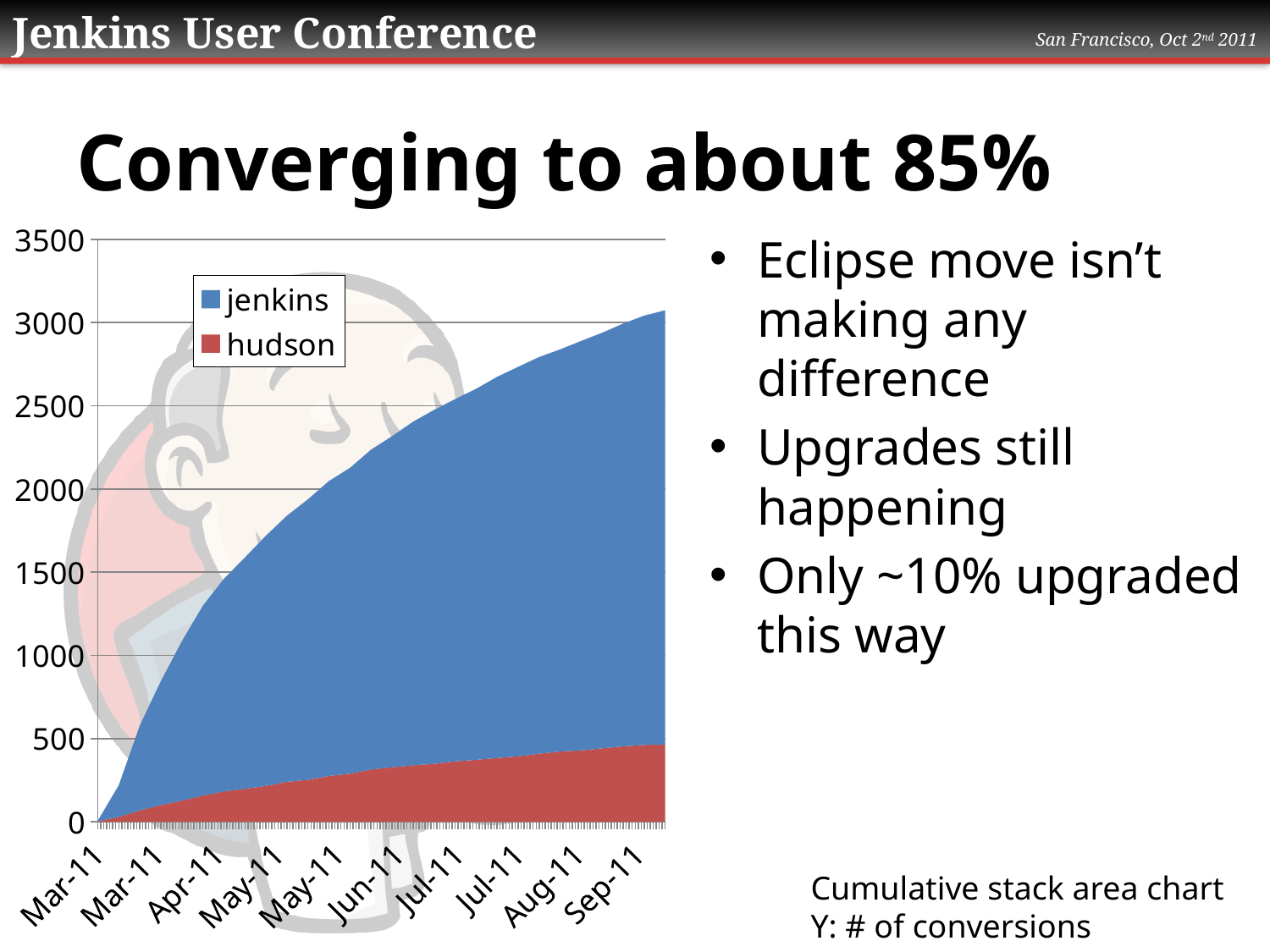
Is the hudson value at Apr-11 greater or less than 500? less Do the cumulative values rise or fall from Mar-11 to Sep-11? rise At which x-axis label does the stacked total reach its highest point? Sep-11 What are the two series named in the chart's legend? jenkins and hudson Is the total stacked value at Jun-11 greater or less than 2000? greater How many series does the chart's legend list? 2 What kind of chart is shown on the slide? stacked area chart What is the highest value shown on the chart's y axis? 3500 Is the total stacked value at Sep-11 greater or less than 2500? greater Which series has the larger cumulative value at Sep-11, jenkins or hudson? jenkins Which colour represents the jenkins series in the chart? blue